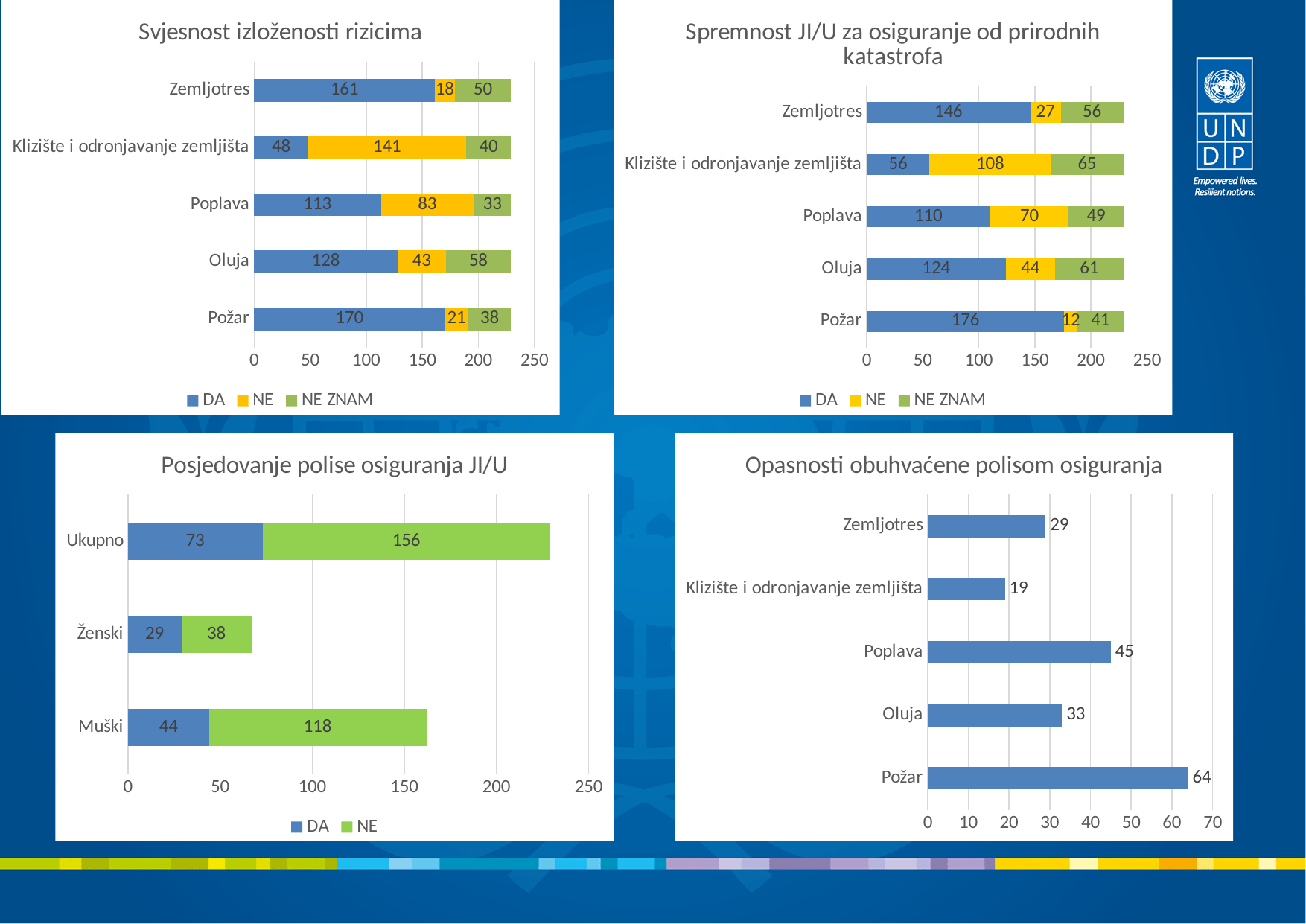
In the chart 'Opasnosti obuhvaćene polisom osiguranja', which category has the lowest value? Klizište i odronjavanje zemljišta In the chart 'Spremnost JI/U za osiguranje od prirodnih katastrofa', how many series does the legend list? 3 In the chart 'Spremnost JI/U za osiguranje od prirodnih katastrofa', what is the difference between the DA values for Požar and Zemljotres? 30 In the chart 'Svjesnost izloženosti rizicima', what is the DA value for Požar? 170 In the chart 'Opasnosti obuhvaćene polisom osiguranja', which is larger, the value for Poplava or the value for Oluja? Poplava What kind of chart is 'Opasnosti obuhvaćene polisom osiguranja'? Bar chart In the chart 'Svjesnost izloženosti rizicima', what is the total of the stacked bar for Zemljotres? 229 In the chart 'Svjesnost izloženosti rizicima', which category has the highest NE value? Klizište i odronjavanje zemljišta In the chart 'Posjedovanje polise osiguranja JI/U', what is the NE value for Muški? 118 In the chart 'Posjedovanje polise osiguranja JI/U', how many categories are shown? 3 In the chart 'Spremnost JI/U za osiguranje od prirodnih katastrofa', what is the NE ZNAM value for Oluja? 61 In the chart 'Posjedovanje polise osiguranja JI/U', what is the total of the stacked bar for Ženski? 67